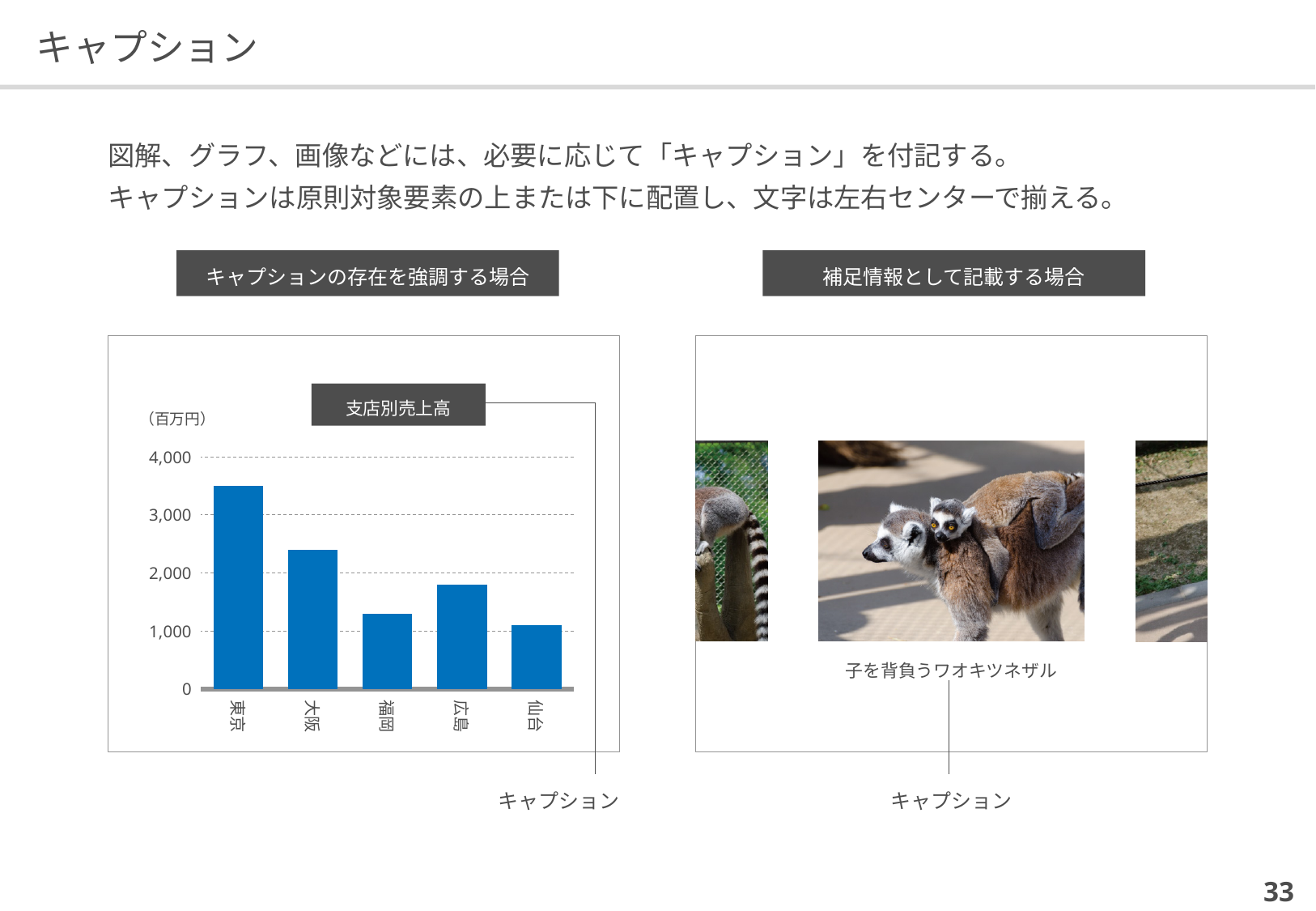
In the 支店別売上高 chart, is the value for 福岡 greater or less than 2,000? less In the 支店別売上高 chart, which is larger, the value for 東京 or the value for 大阪? 東京 How many branches (categories) are plotted in the 支店別売上高 chart? 5 Which branch has the lowest value in the 支店別売上高 chart? 仙台 In the 支店別売上高 chart, which is larger, the value for 広島 or the value for 福岡? 広島 What unit is shown at the top of the vertical axis of the 支店別売上高 chart? 百万円 In the 支店別売上高 chart, is the value for 大阪 greater or less than 2,000? greater In the 支店別売上高 chart, is the value for 東京 greater or less than 3,000? greater In the 支店別売上高 chart, do the values rise or fall going from 東京 to 大阪 to 福岡? fall Which branch has the highest value in the 支店別売上高 chart? 東京 What kind of chart is shown under the heading 支店別売上高? bar chart